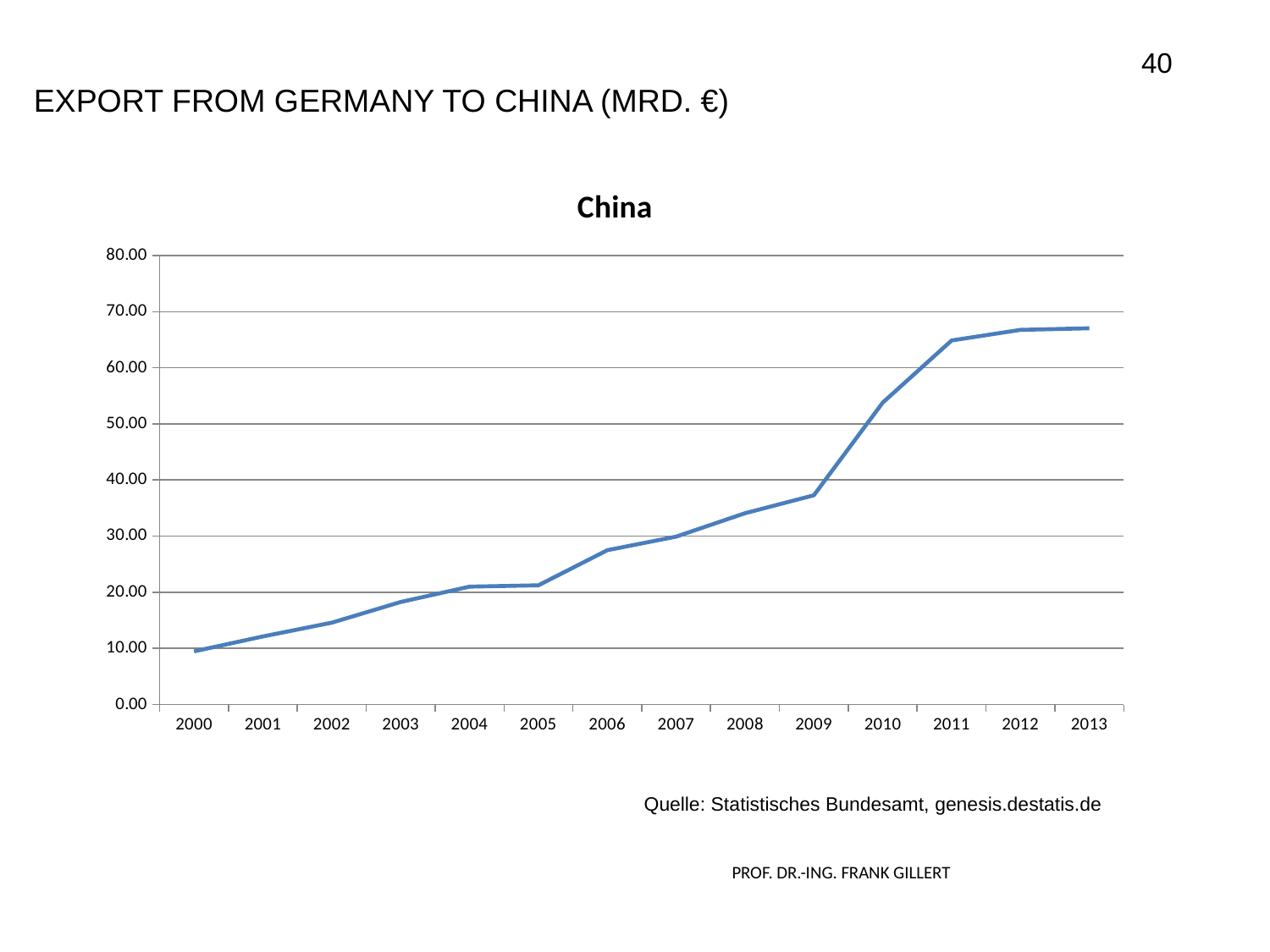
What kind of chart is shown on the slide? line chart Is the value for 2011 greater or less than 60.00? greater What is the title shown above the chart? China Is the value for 2010 greater or less than 50.00? greater How many years are plotted on the x axis of the chart? 14 Which year has the lowest export value in the chart? 2000 Which year has the larger export value, 2009 or 2010? 2010 Is the value for 2013 greater or less than 70.00? less What is the highest value shown on the y axis of the chart? 80.00 Do the export values generally rise or fall from 2000 to 2013? rise